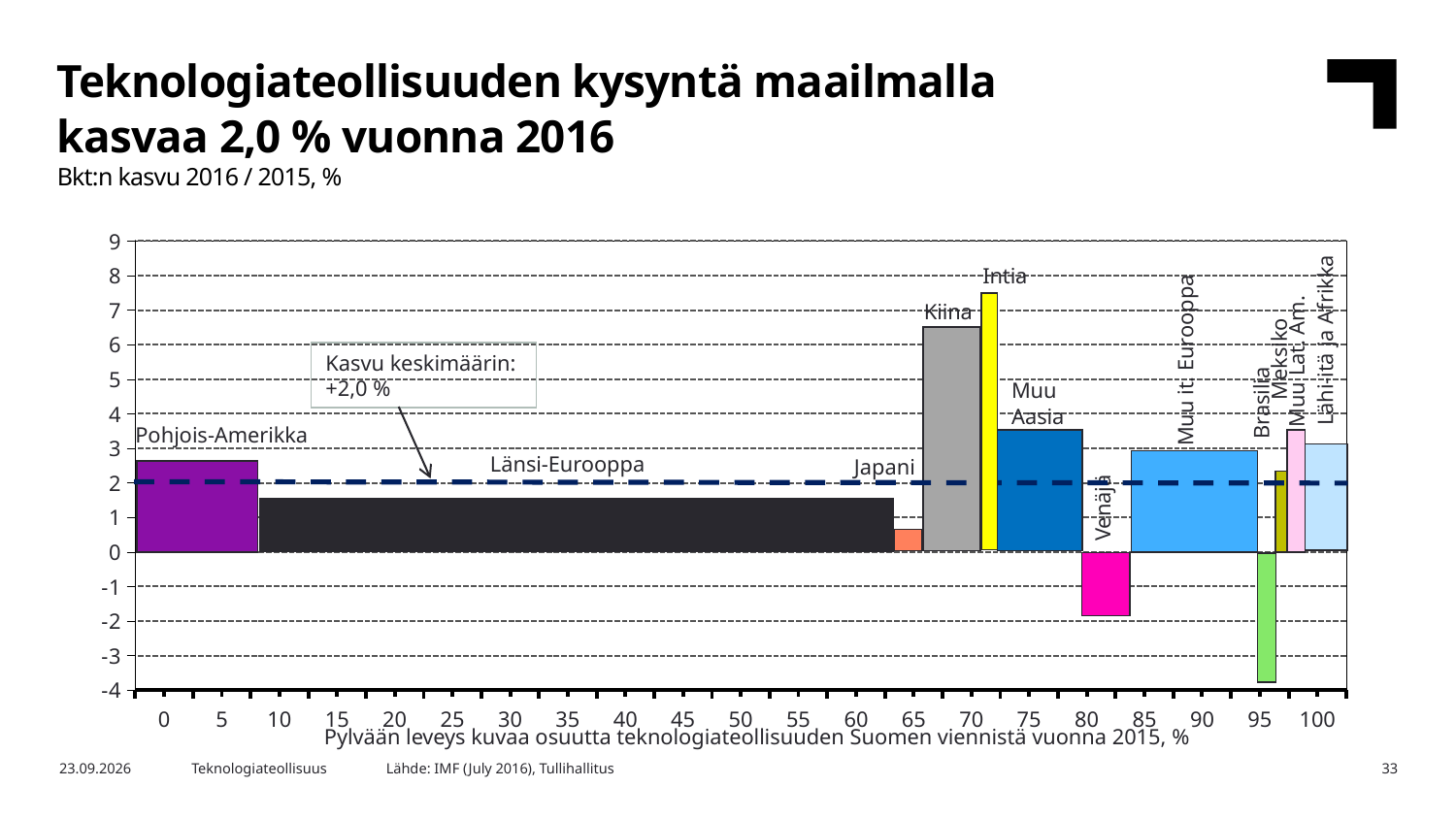
How many regions show negative GDP growth in the chart? 2 How many regions are shown in the chart? 12 What average growth does the dashed line in the chart represent? +2,0 % Is the value for Japani greater or less than 1? less What kind of chart is shown on the slide? bar chart Which has the higher GDP growth, Pohjois-Amerikka or Länsi-Eurooppa? Pohjois-Amerikka Is the value for Kiina greater or less than 5? greater Which region has the highest GDP growth in the chart? Intia Which region has the lowest GDP growth in the chart? Brasilia Is the value for Länsi-Eurooppa greater or less than 2? less Which has the higher GDP growth, Kiina or Intia? Intia